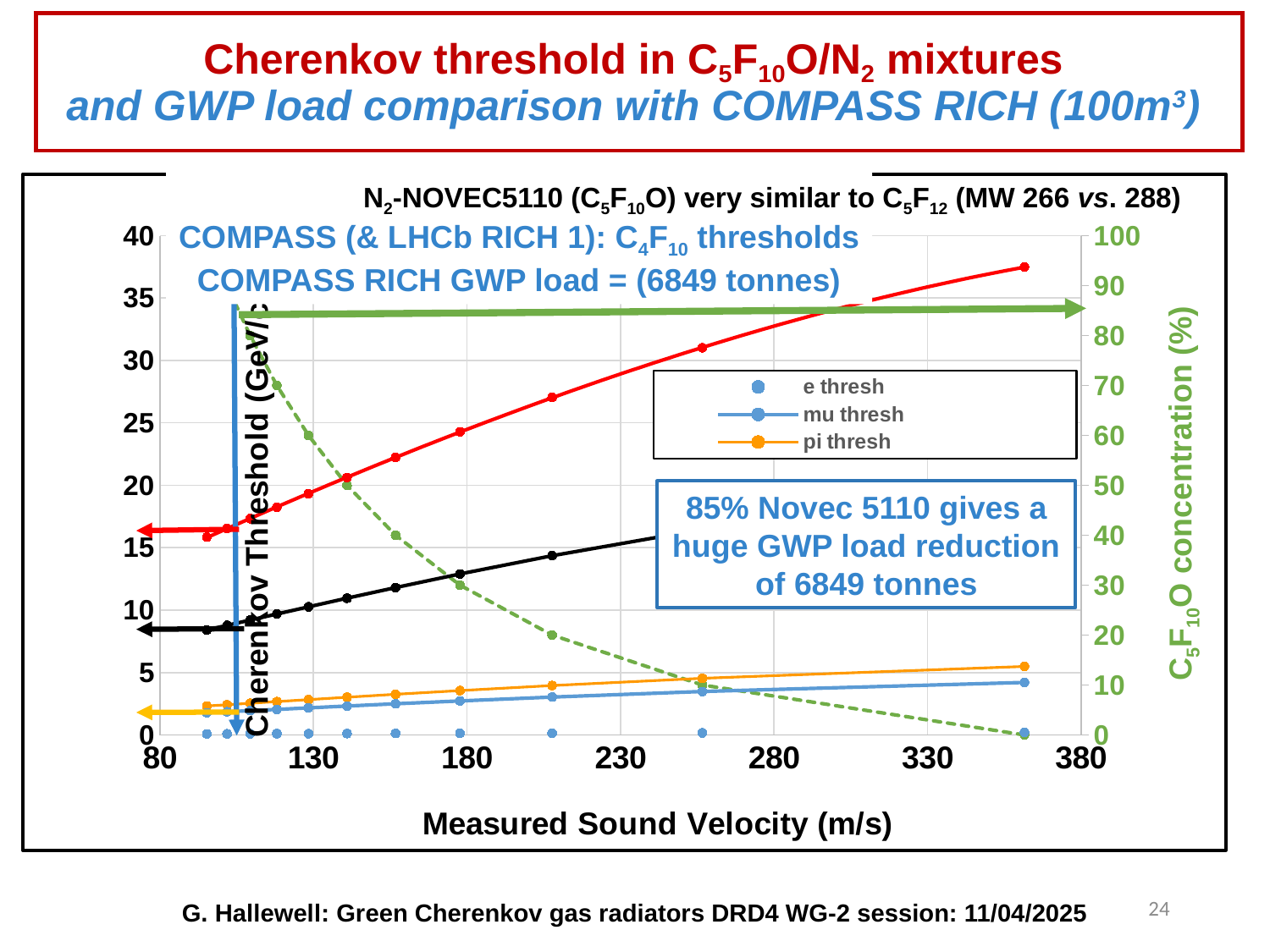
Is the green dashed line at about 360 m/s greater or less than 10 on the right axis? less What is the title of the x axis of the chart? Measured Sound Velocity (m/s) What kind of chart is shown on the slide? line chart Does the green dashed line rise or fall as the measured sound velocity increases? falls At about 360 m/s, which is larger: the pi thresh value or the mu thresh value? pi thresh Does the red line rise or fall as the measured sound velocity increases? rises Is the value of the mu thresh series at about 360 m/s greater or less than 5 on the left axis? less Is the value of the black line at about 180 m/s greater or less than 15 on the left axis? less What is the title of the right-hand y axis of the chart? C5F10O concentration (%) How many series does the chart's legend list? 3 Does the mu thresh series rise or fall as the measured sound velocity increases? rises